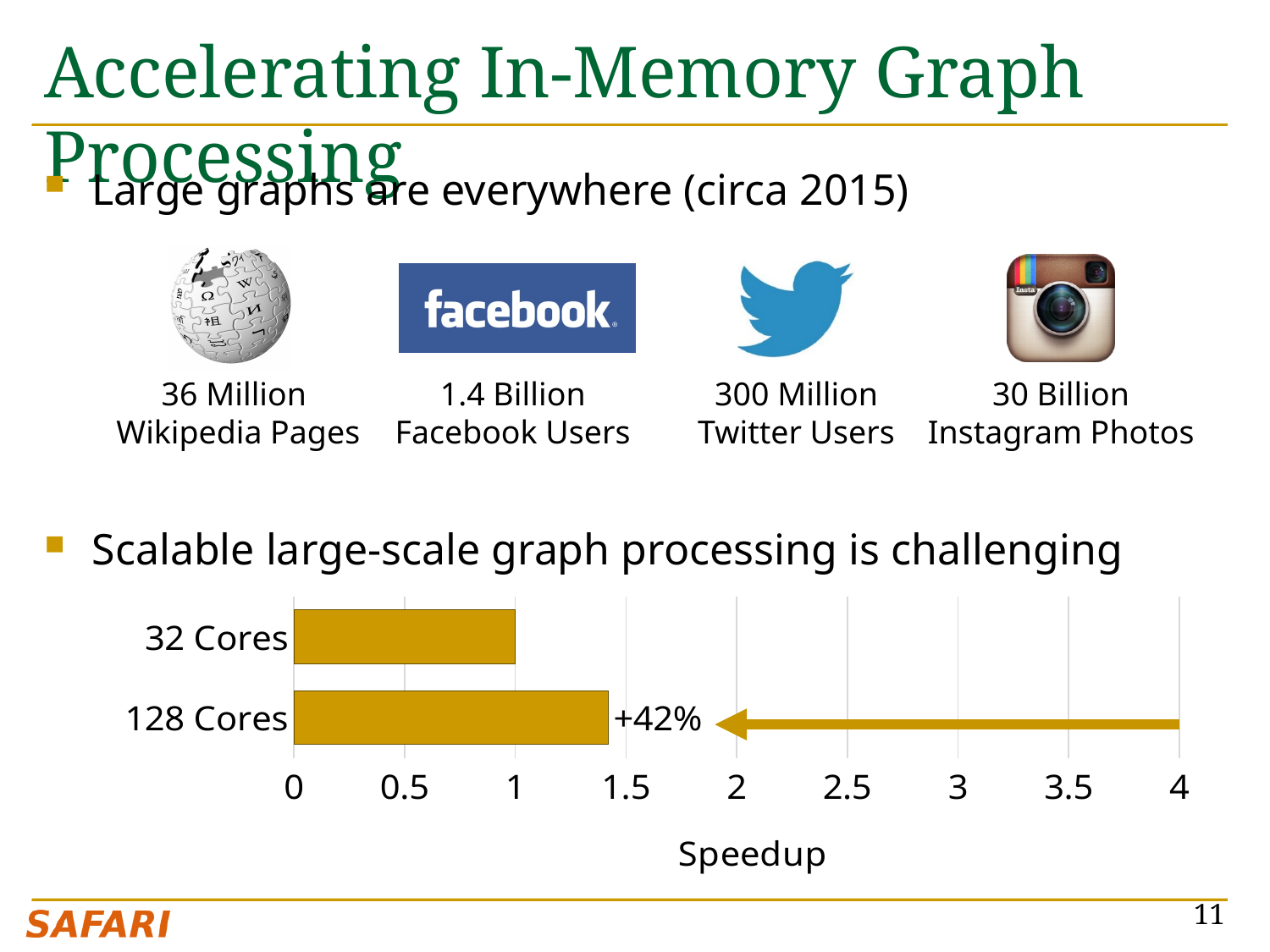
Which category has the lowest speedup in the bar chart? 32 Cores What is the speedup value for 32 Cores in the bar chart? 1 What annotation is printed next to the 128 Cores bar? +42% Which category has the highest speedup in the bar chart? 128 Cores Is the speedup for 128 Cores greater or less than 1.5? less Which has a larger speedup, 32 Cores or 128 Cores? 128 Cores Is the speedup for 128 Cores greater or less than 1? greater How many categories does the bar chart show? 2 What is the label of the x axis in the bar chart? Speedup What kind of chart is shown at the bottom of the slide? bar chart What is the maximum value shown on the x axis of the bar chart? 4